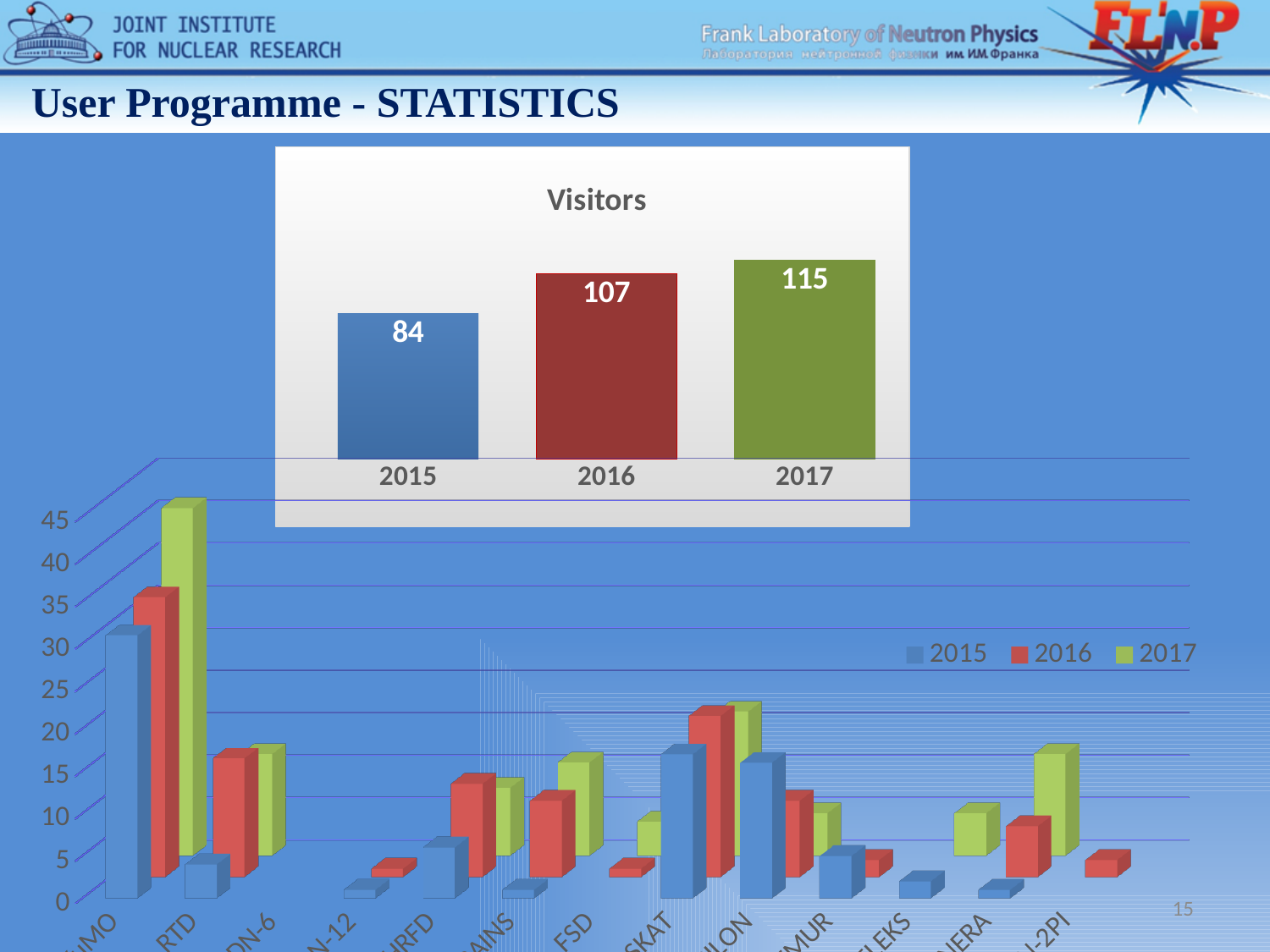
In the Visitors chart, which year has the highest number of visitors? 2017 What kind of chart is the Visitors chart? bar chart In the Visitors chart, how many years are shown? 3 In the lower chart with the instrument categories, how many series does the legend list? 3 In the Visitors chart, which year has the lowest number of visitors? 2015 In the Visitors chart, what is the difference between the 2017 and 2015 values? 31 In the lower chart with the instrument categories, is the 2015 value for RTD greater or less than 10? less In the Visitors chart, what is the value for 2016? 107 In the Visitors chart, what is the difference between the 2016 and 2015 values? 23 In the Visitors chart, do the values rise or fall from 2015 to 2017? rise In the Visitors chart, how many visitors were there in 2015? 84 In the Visitors chart, what is the value for 2017? 115